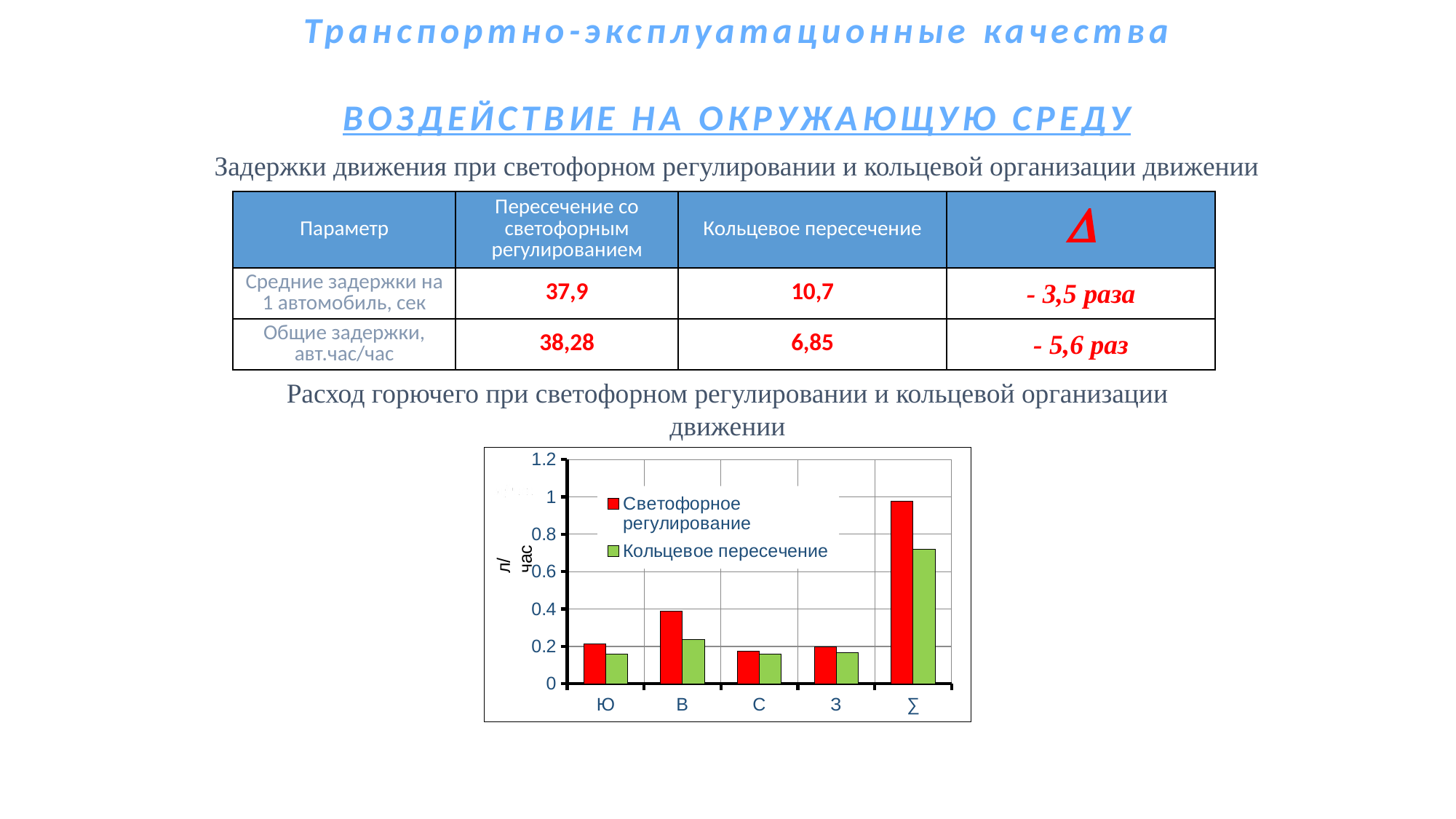
Which colour represents Кольцевое пересечение in the chart? green At category В, which series has the larger value: Светофорное регулирование or Кольцевое пересечение? Светофорное регулирование Is the value for Кольцевое пересечение at Ю greater or less than 0.2? less How many series does the chart legend list? 2 Is the value for Светофорное регулирование at ∑ greater or less than 0.8? greater Is the value for Светофорное регулирование at В greater or less than 0.2? greater Which category has the highest value for Светофорное регулирование? ∑ What kind of chart is shown on the slide? bar chart What is the label on the vertical axis of the chart? л/час How many categories are shown on the x axis of the chart? 5 Which category has the highest value for Кольцевое пересечение? ∑